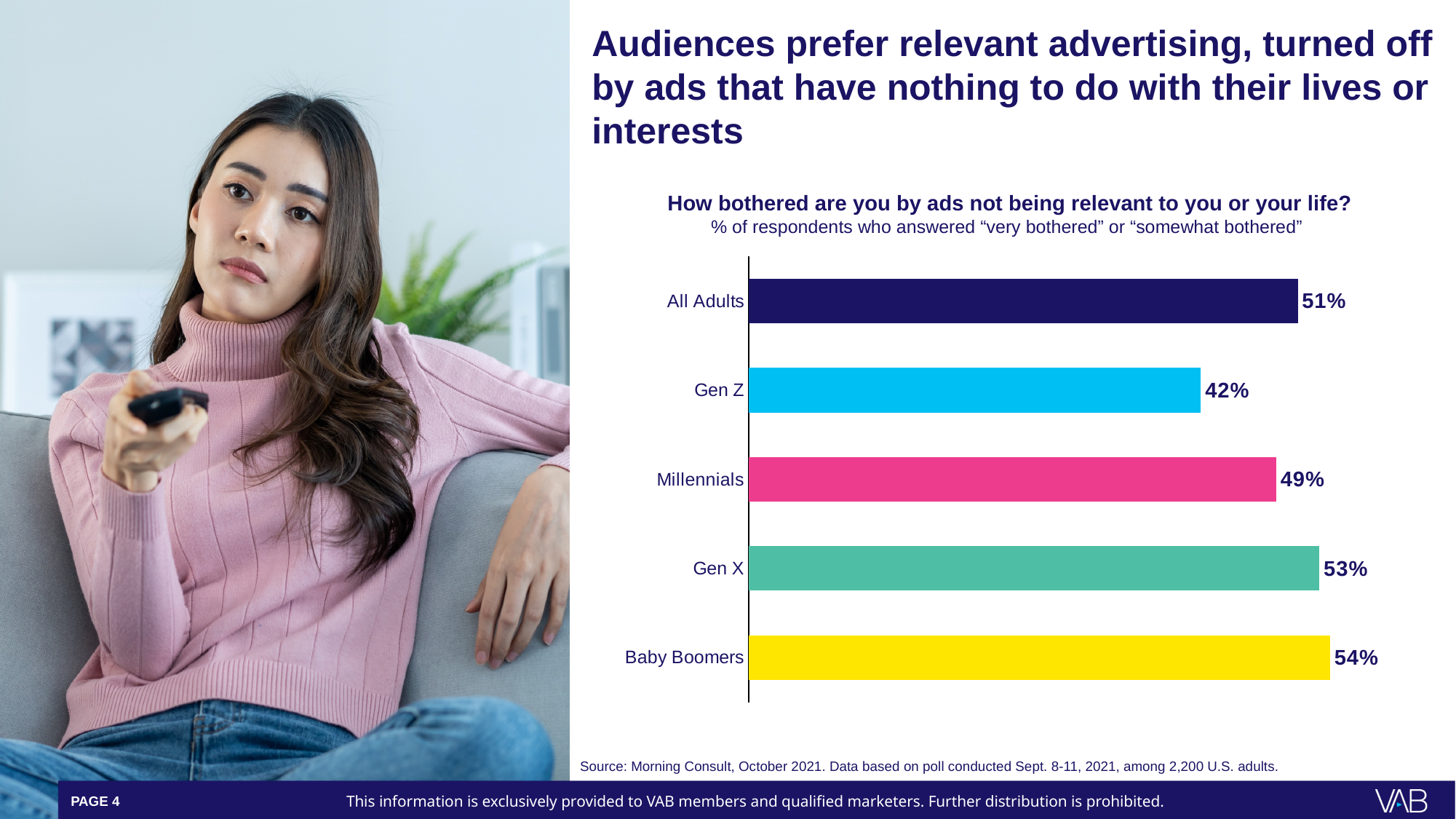
What is the value shown for Millennials? 49% Which category has the lowest value? Gen Z What colour is the bar for Baby Boomers? Yellow How many categories are shown in the chart? 5 Which is larger, the value for Millennials or the value for Gen Z? Millennials What is the value shown for Gen Z? 42% What is the value shown for Gen X? 53% Which category has the highest value? Baby Boomers What percentage of All Adults answered "very bothered" or "somewhat bothered"? 51% What is the difference between the values for Gen X and Millennials? 4% What kind of chart is shown on the slide? Bar chart What is the difference between the values for Baby Boomers and Gen Z? 12%